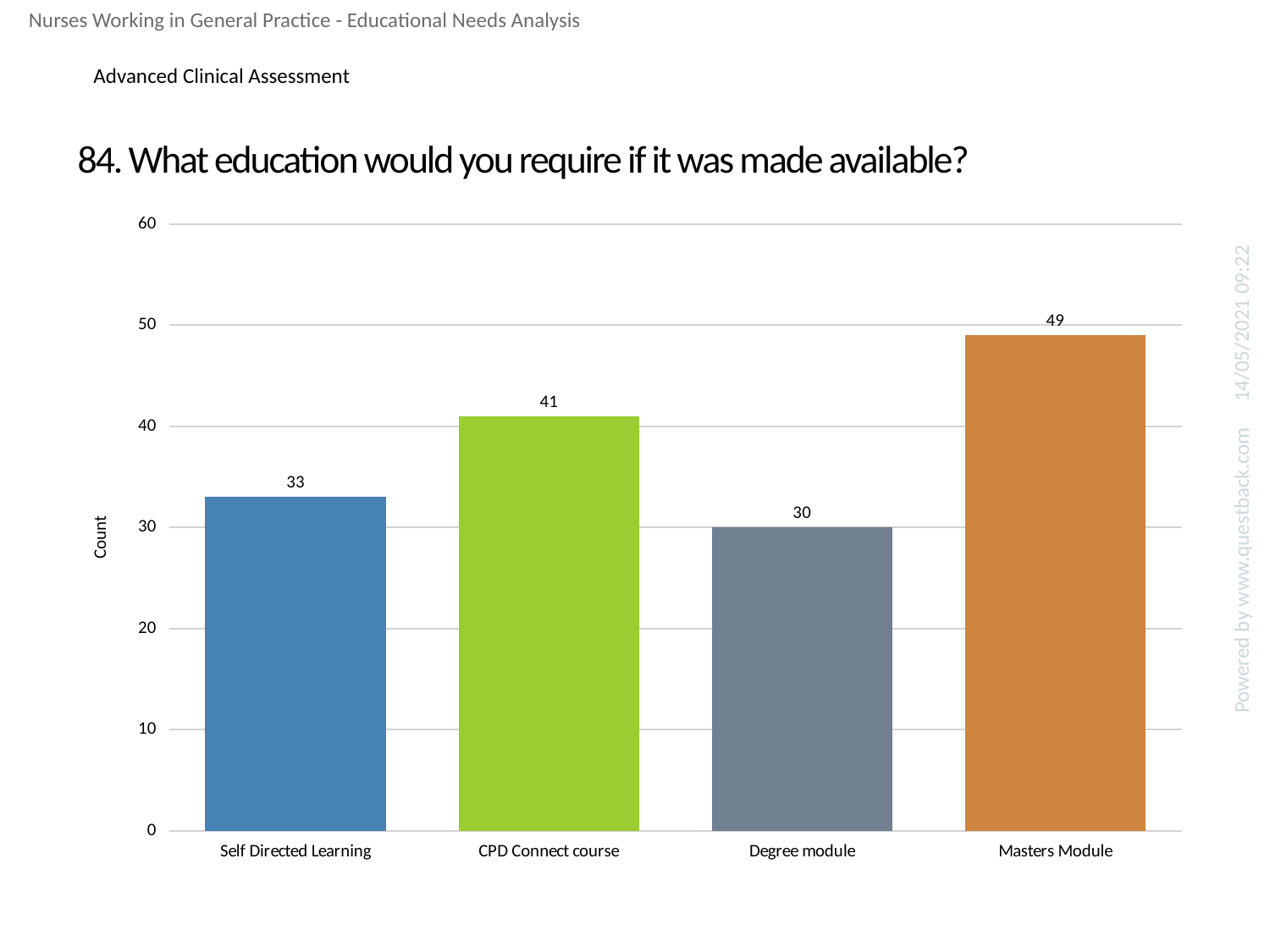
What kind of chart is shown on the slide? Bar chart What is the label of the y axis? Count Which category has the lowest count? Degree module What is the count for Masters Module? 49 What is the count for Degree module? 30 What is the count for Self Directed Learning? 33 What is the difference between the counts for CPD Connect course and Self Directed Learning? 8 How many categories are shown on the x axis? 4 Which has a larger count, Self Directed Learning or CPD Connect course? CPD Connect course What is the difference between the counts for Masters Module and Degree module? 19 What is the count for CPD Connect course? 41 Which category has the highest count? Masters Module